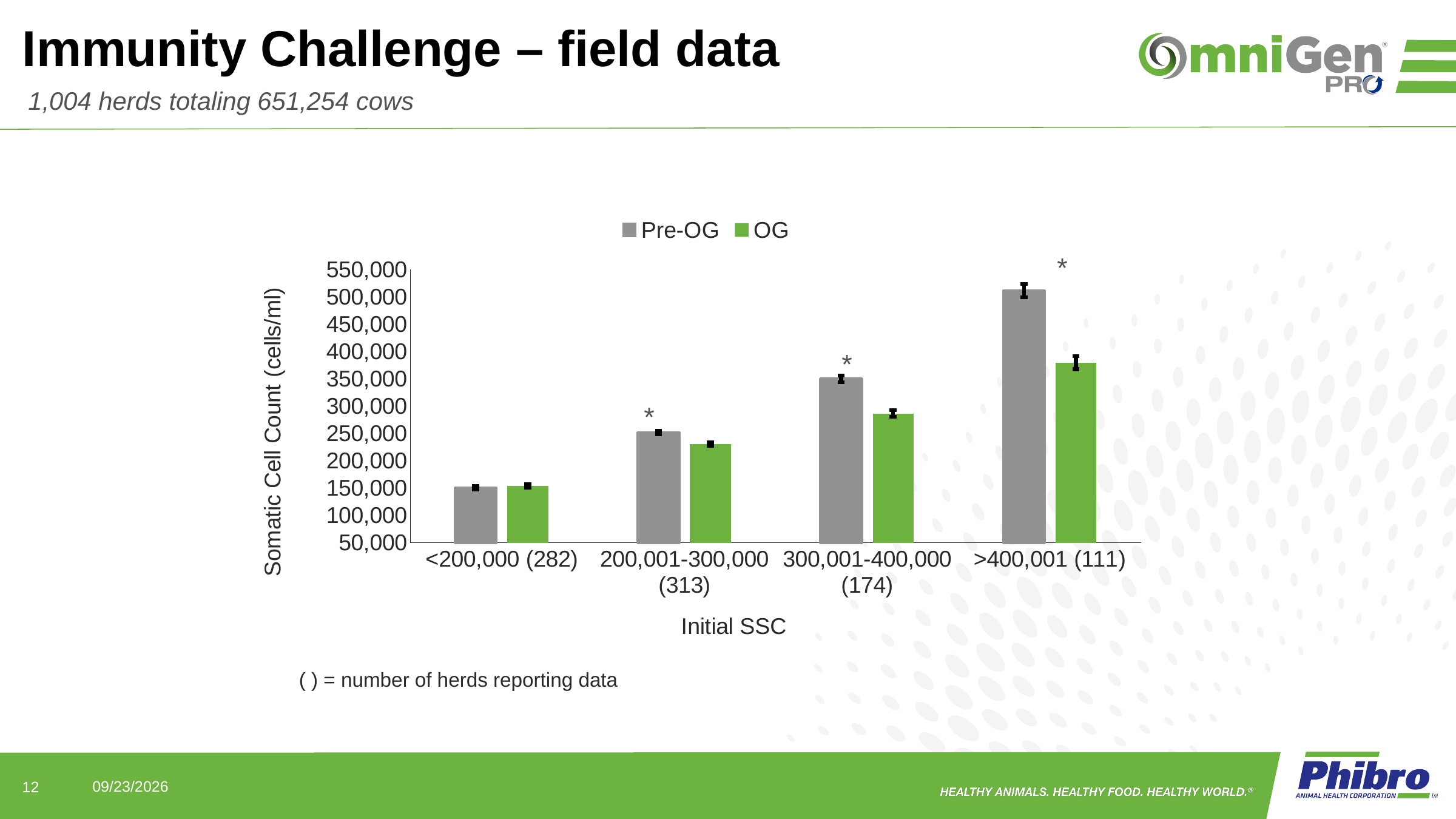
Which Initial SSC category has the highest Pre-OG value? >400,001 (111) Which Initial SSC category has the lowest OG value? <200,000 (282) Is the Pre-OG value for 300,001-400,000 (174) greater or less than 300,000? greater For the >400,001 (111) category, which is larger, Pre-OG or OG? Pre-OG Is the OG value for >400,001 (111) greater or less than 400,000? less What kind of chart is shown on the slide? Bar chart Do the Pre-OG values rise or fall moving from left to right across the Initial SSC categories? Rise What is the title of the y axis? Somatic Cell Count (cells/ml) For the 300,001-400,000 (174) category, which is larger, Pre-OG or OG? Pre-OG Is the Pre-OG value for >400,001 (111) greater or less than 450,000? greater How many Initial SSC categories are shown on the x axis? 4 How many series does the legend list? 2